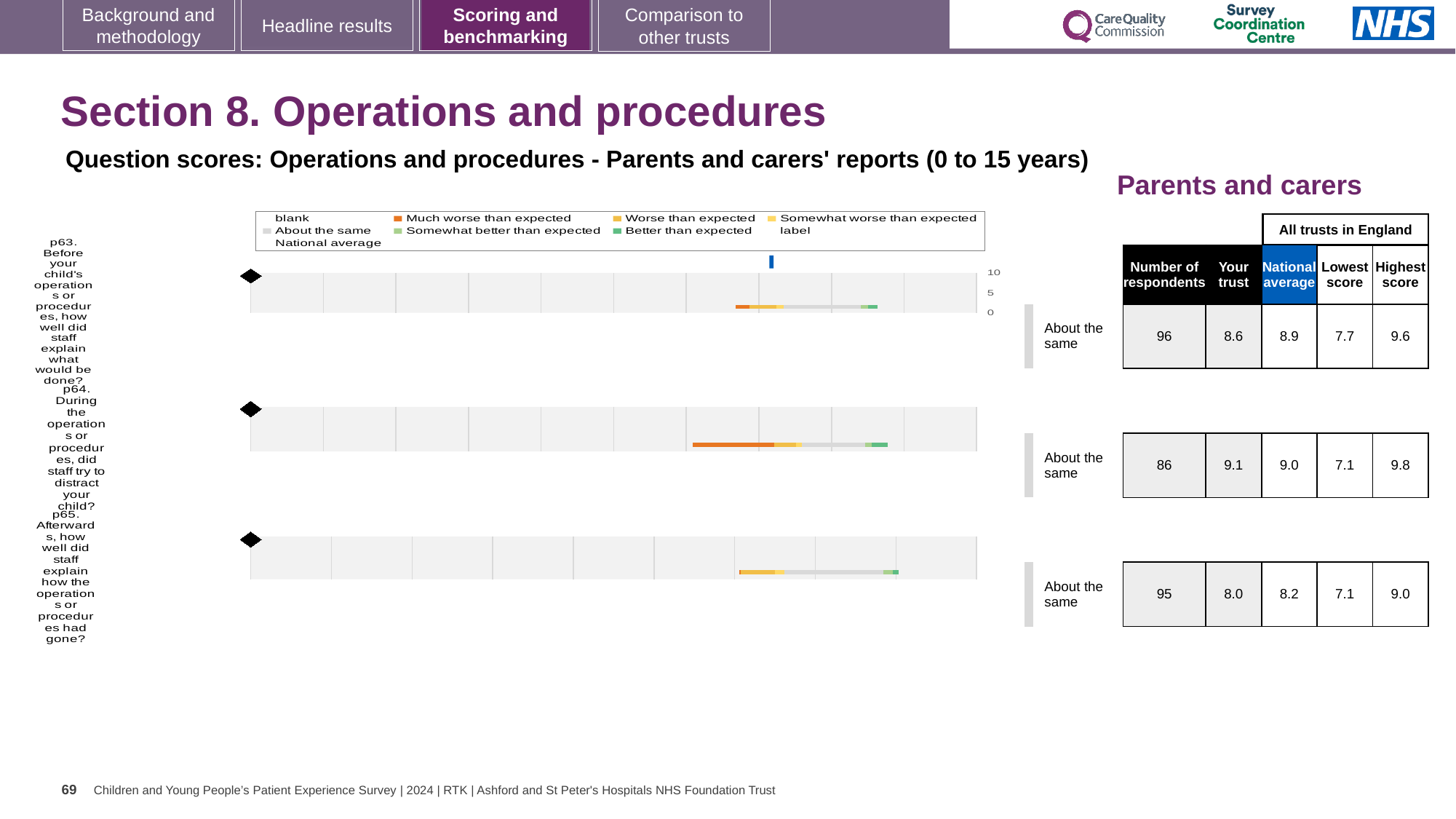
For p64, what is the difference between the highest score and the lowest score across all trusts in England? 2.7 For p65, how much higher is the national average than the 'Your trust' score? 0.2 What is the national average score for p64 (During the operations or procedures, did staff try to distract your child?)? 9.0 Which question has the highest 'Your trust' score? p64 What is the lowest score across all trusts in England for p63? 7.7 How many questions are plotted on this slide? 3 How many respondents answered p65 (Afterwards, how well did staff explain how the operations or procedures had gone?)? 95 Which question has the lowest 'Your trust' score? p65 What benchmark category is shown for all three questions? About the same What kind of chart is used to show the question scores? Bar chart For p63, which is larger: the 'Your trust' score or the national average? National average What is the 'Your trust' score for p63 (Before your child's operations or procedures, how well did staff explain what would be done?)? 8.6